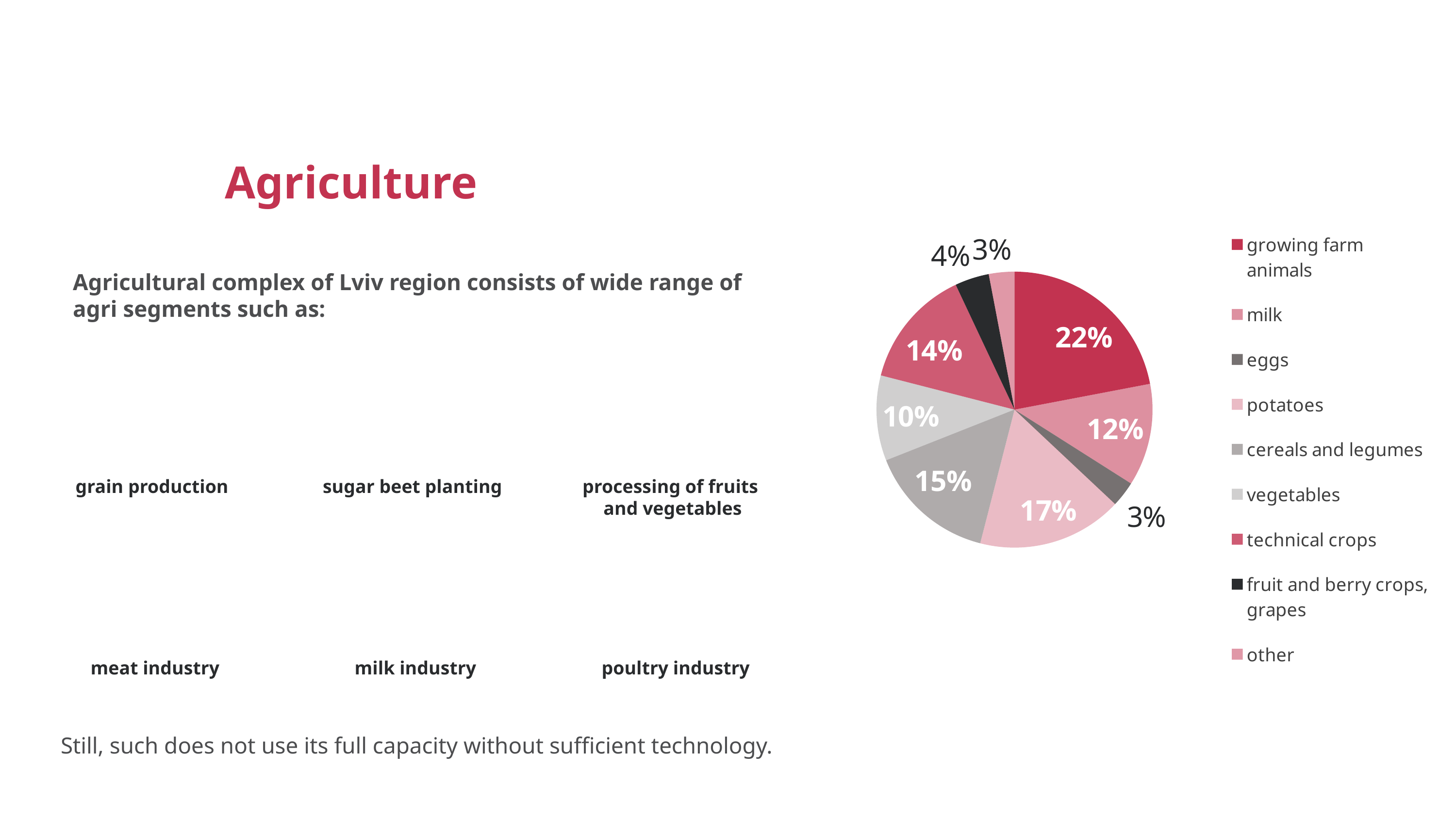
What is the value for technical crops in the pie chart? 14% What colour is the slice for fruit and berry crops, grapes? black What is the value for cereals and legumes in the pie chart? 15% What share of the pie does growing farm animals have? 22% What is the value for vegetables in the pie chart? 10% Which category has the largest slice of the pie? growing farm animals What is the value for potatoes in the pie chart? 17% What kind of chart is shown on the slide? pie chart How many categories does the legend of the pie chart list? 9 What is the value for fruit and berry crops, grapes in the pie chart? 4% Which is larger, the share for potatoes or the share for cereals and legumes? potatoes What is the difference between the shares of growing farm animals and milk? 10%